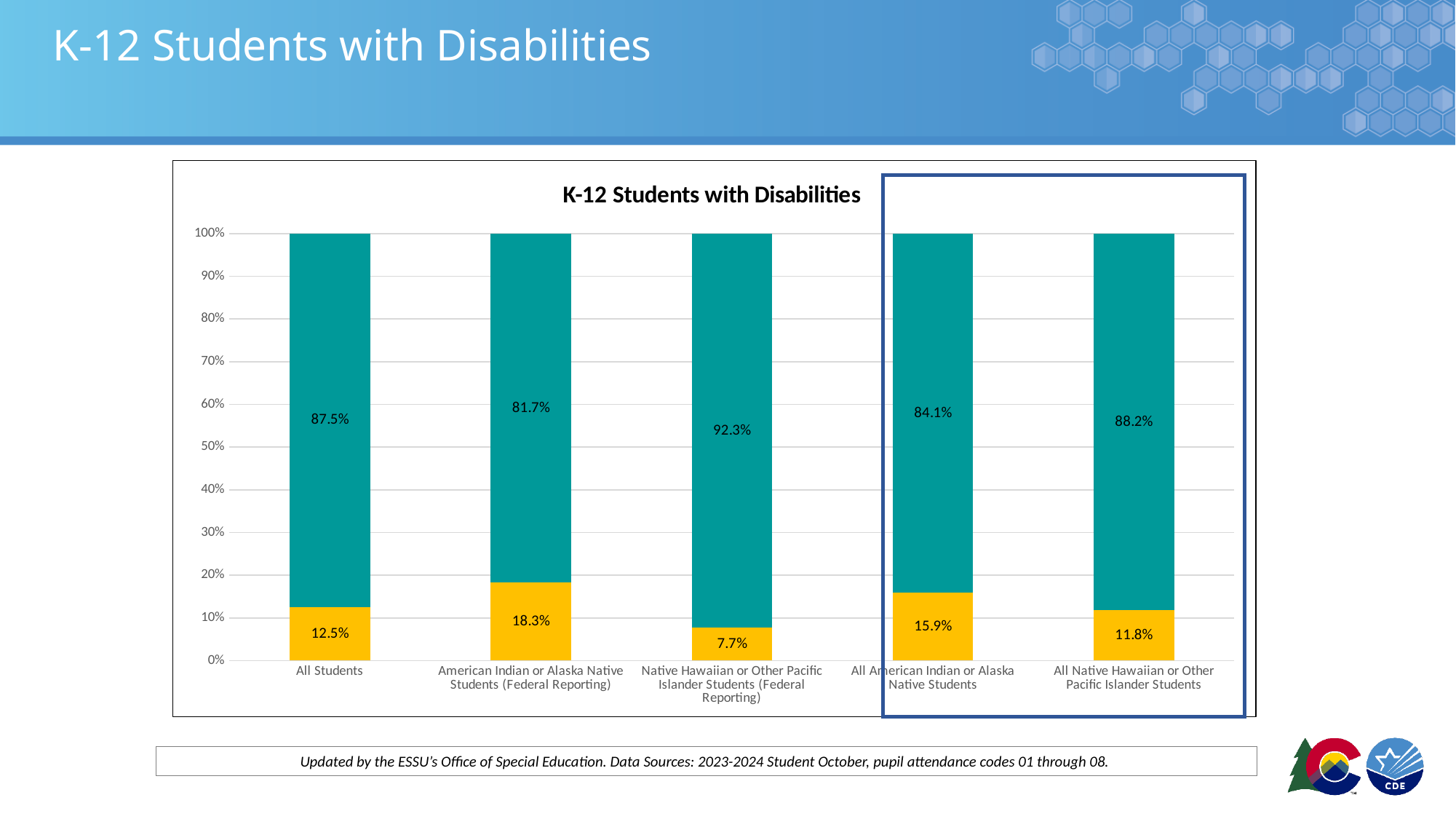
Which is larger: the yellow segment for All American Indian or Alaska Native Students or for All Native Hawaiian or Other Pacific Islander Students? All American Indian or Alaska Native Students What is the total of the stacked bar for All Students? 100% What is the value of the yellow (bottom) segment for All American Indian or Alaska Native Students? 15.9% What is the value of the teal (top) segment for Native Hawaiian or Other Pacific Islander Students (Federal Reporting)? 92.3% What is the difference between the yellow segment values for American Indian or Alaska Native Students (Federal Reporting) and All Students? 5.8% What is the value of the yellow (bottom) segment for All Students? 12.5% What is the value of the teal (top) segment for All Native Hawaiian or Other Pacific Islander Students? 88.2% Which category has the smallest yellow (bottom) segment? Native Hawaiian or Other Pacific Islander Students (Federal Reporting) What is the title of the chart? K-12 Students with Disabilities How many categories are shown on the x axis? 5 Which category has the largest yellow (bottom) segment? American Indian or Alaska Native Students (Federal Reporting) What kind of chart is shown on the slide? Stacked bar chart